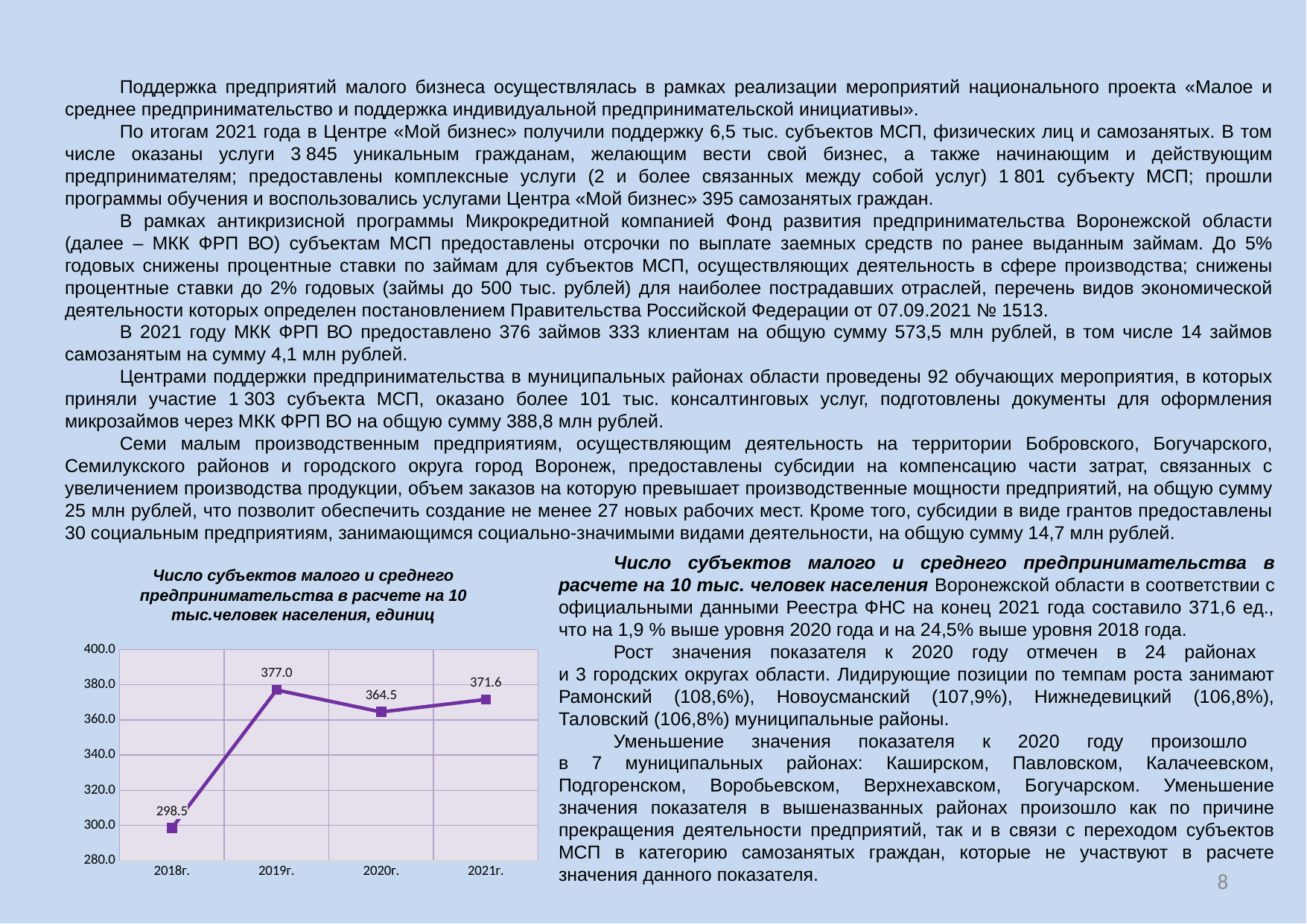
What is the title of the chart? Число субъектов малого и среднего предпринимательства в расчете на 10 тыс.человек населения, единиц What is the value for 2020г. in the chart? 364.5 What is the value for 2019г. in the chart? 377.0 What is the value for 2021г. in the chart? 371.6 Which year has the lowest value in the chart? 2018г. What type of chart is shown on the slide? line chart What is the difference between the values for 2021г. and 2020г.? 7.1 Which is larger, the value for 2020г. or the value for 2021г.? 2021г. What is the value for 2018г. in the chart? 298.5 How many data points are plotted in the chart? 4 What is the difference between the values for 2019г. and 2018г.? 78.5 Which year has the highest value in the chart? 2019г.